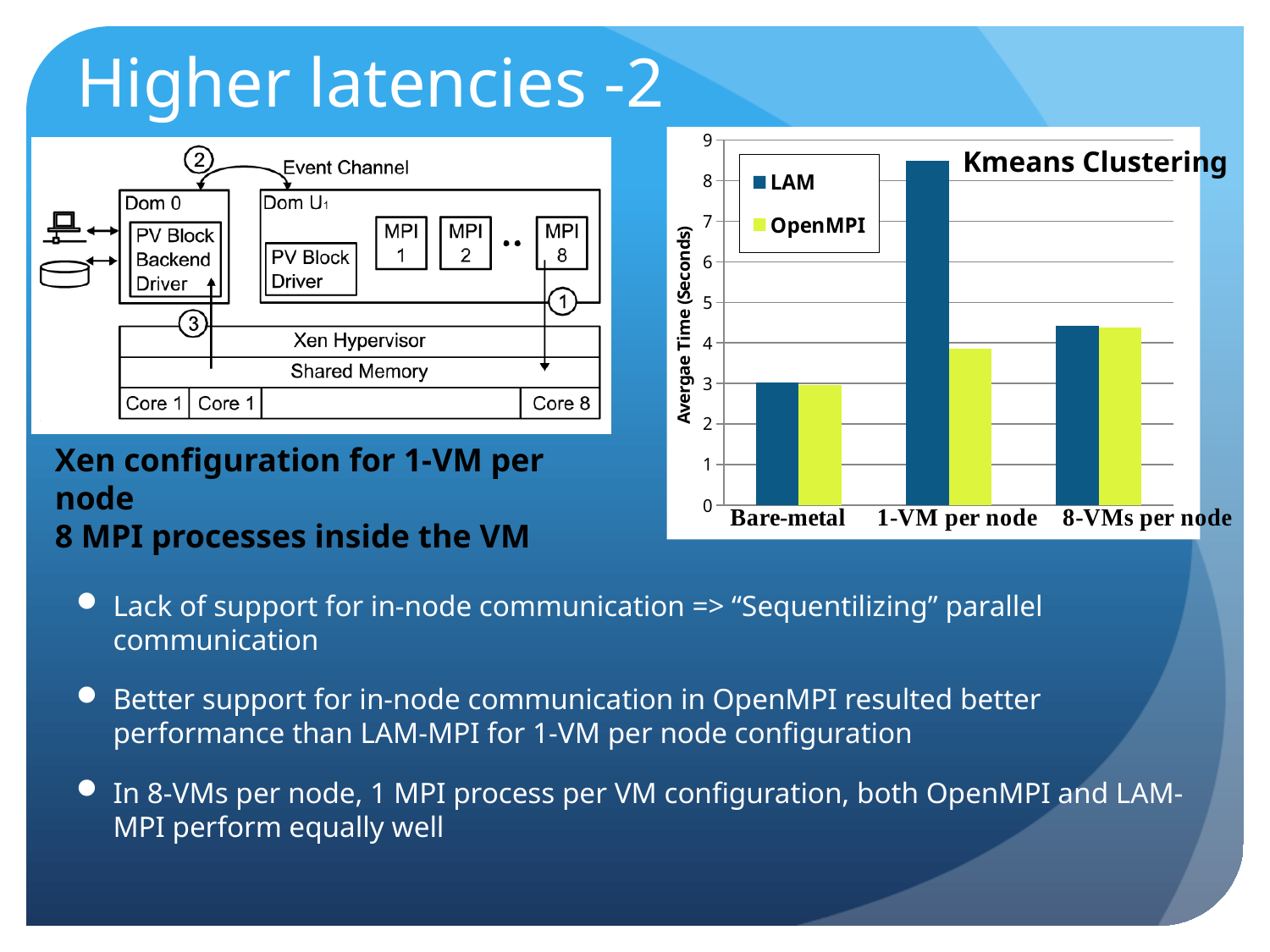
In the Kmeans Clustering chart, is the LAM value for 1-VM per node greater or less than 8? greater What is the title of the chart on the slide? Kmeans Clustering In the Kmeans Clustering chart, is the OpenMPI value for 1-VM per node greater or less than 4? less In the Kmeans Clustering chart, which category has the lowest LAM value? Bare-metal What is the y-axis label of the Kmeans Clustering chart? Avergae Time (Seconds) In the Kmeans Clustering chart, which category has the highest OpenMPI value? 8-VMs per node How many series does the legend of the Kmeans Clustering chart list? 2 In the Kmeans Clustering chart, is the LAM value for 8-VMs per node greater or less than 4? greater In the Kmeans Clustering chart, which category has the highest LAM value? 1-VM per node In the Kmeans Clustering chart, for 1-VM per node, which is larger: LAM or OpenMPI? LAM How many categories are shown on the x axis of the Kmeans Clustering chart? 3 What kind of chart is the Kmeans Clustering chart? bar chart